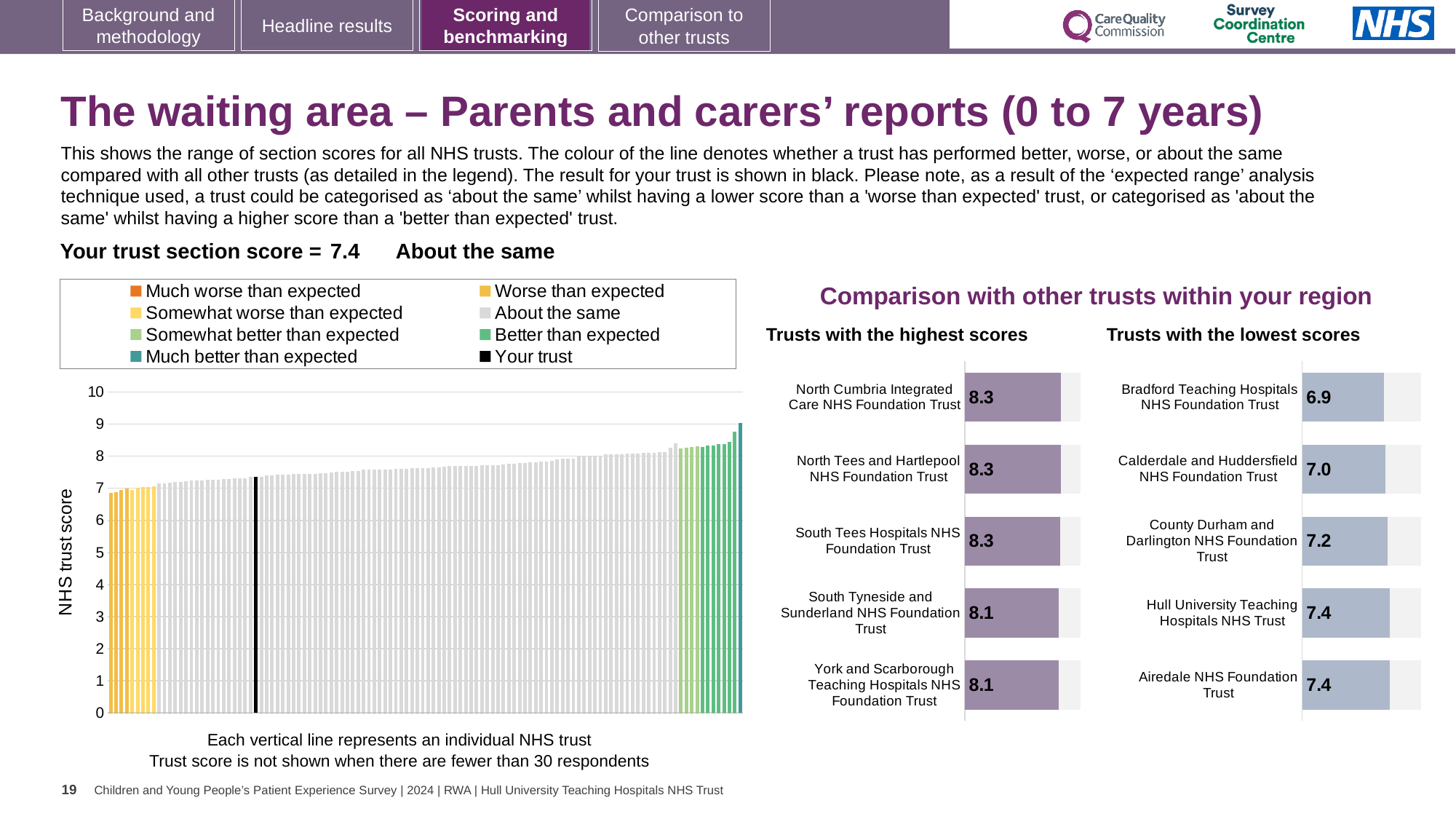
In the 'Trusts with the lowest scores' chart, which has the higher score: Calderdale and Huddersfield NHS Foundation Trust or County Durham and Darlington NHS Foundation Trust? County Durham and Darlington NHS Foundation Trust How many entries does the legend of the large chart on the left list? 8 What is the y-axis label of the large chart on the left? NHS trust score How many trusts are listed in the 'Trusts with the highest scores' chart? 5 What type of chart is the large chart on the left showing NHS trust scores? Bar chart In the 'Trusts with the lowest scores' chart, which trust has the lowest score? Bradford Teaching Hospitals NHS Foundation Trust In the 'Trusts with the highest scores' chart, what is the difference between the scores of South Tees Hospitals NHS Foundation Trust and South Tyneside and Sunderland NHS Foundation Trust? 0.2 In the 'Trusts with the lowest scores' chart, what is the difference between the scores of Hull University Teaching Hospitals NHS Trust and Bradford Teaching Hospitals NHS Foundation Trust? 0.5 In the 'Trusts with the highest scores' chart, what is the score for North Cumbria Integrated Care NHS Foundation Trust? 8.3 In the 'Trusts with the lowest scores' chart, what is the score for Bradford Teaching Hospitals NHS Foundation Trust? 6.9 In the 'Trusts with the highest scores' chart, what is the score for York and Scarborough Teaching Hospitals NHS Foundation Trust? 8.1 In the large chart on the left, is the value of the tallest bar greater or less than 8? greater